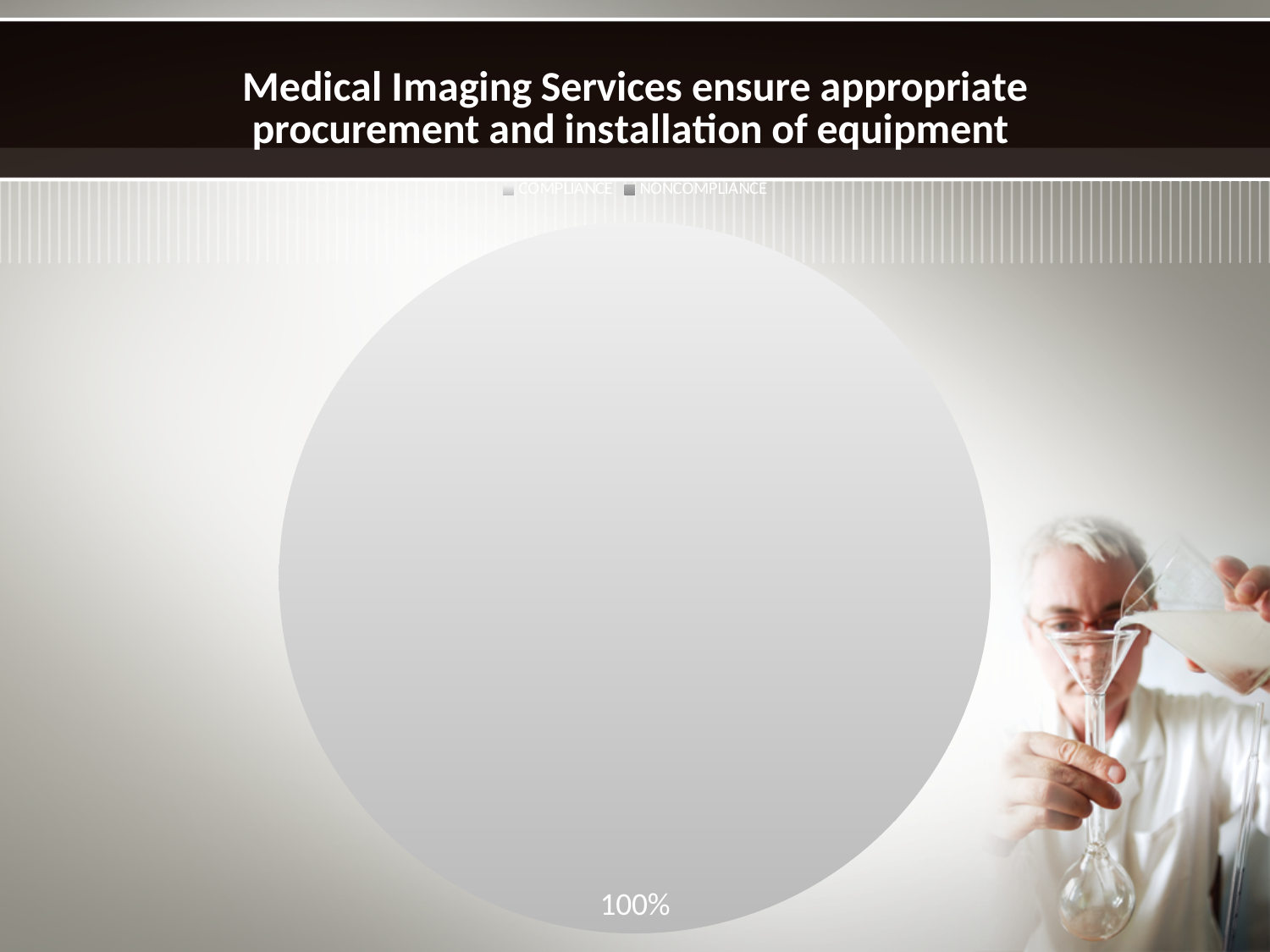
How many slices with a printed data label does the pie chart have? 1 How many entries does the chart legend list? 2 What percentage label is printed on the pie chart? 100% What are the two entries in the chart legend? COMPLIANCE and NONCOMPLIANCE What kind of chart is shown on the slide? pie chart What is the title of the slide containing the pie chart? Medical Imaging Services ensure appropriate procurement and installation of equipment What share of the pie does the single labelled slice take up? 100%